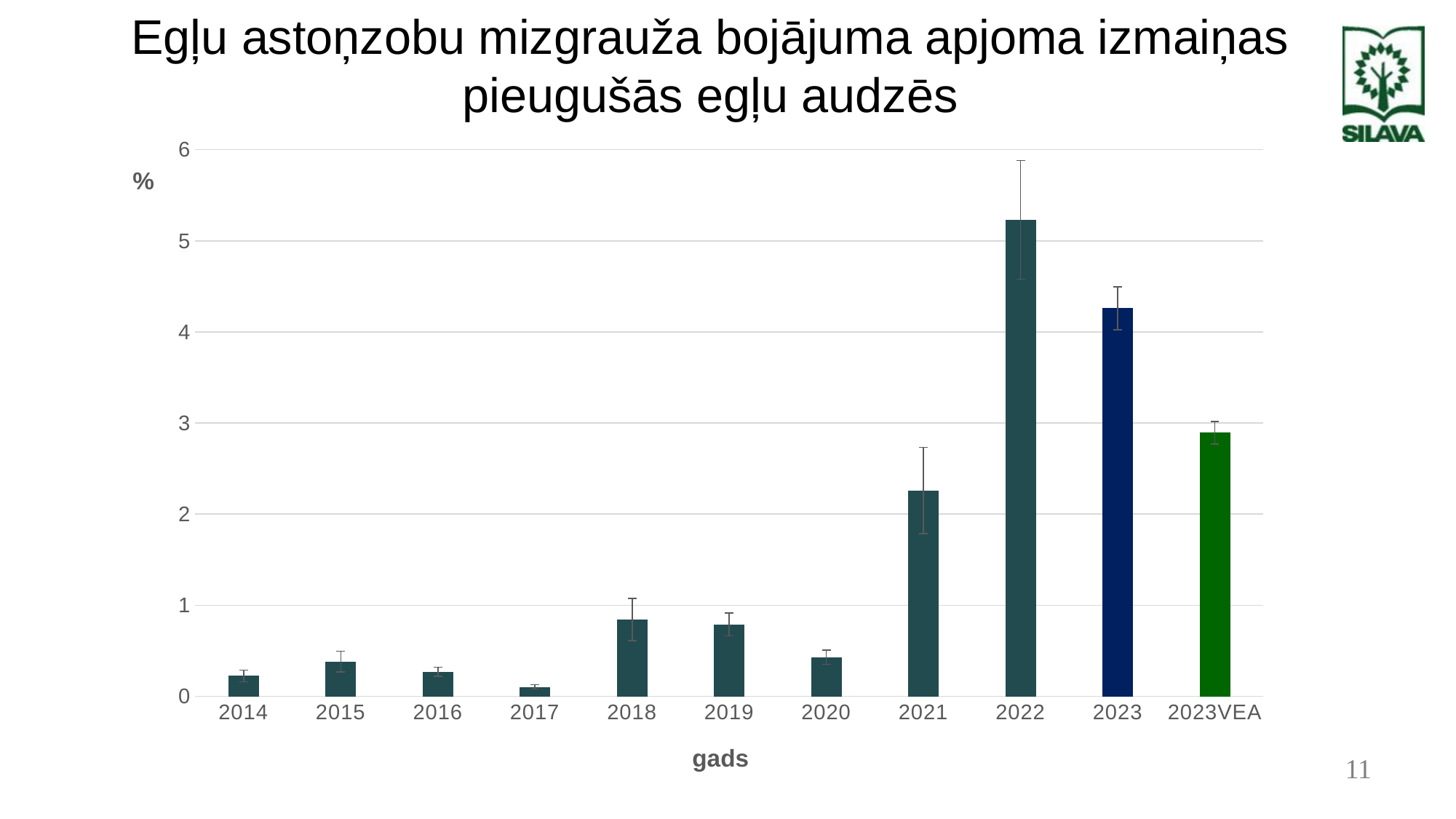
Which category has the lowest value in the chart? 2017 Is the value for 2023 greater or less than 4? greater Is the value for 2022 greater or less than 5? greater Which is larger, the value for 2021 or the value for 2023VEA? 2023VEA Which category has the highest value in the chart? 2022 How many categories are shown on the x axis of the chart? 11 Is the value for 2023VEA greater or less than 3? less Which is larger, the value for 2022 or the value for 2023? 2022 Do the values rise or fall from 2020 to 2022? rise What kind of chart is shown on the slide? bar chart What is the label on the x axis of the chart? gads